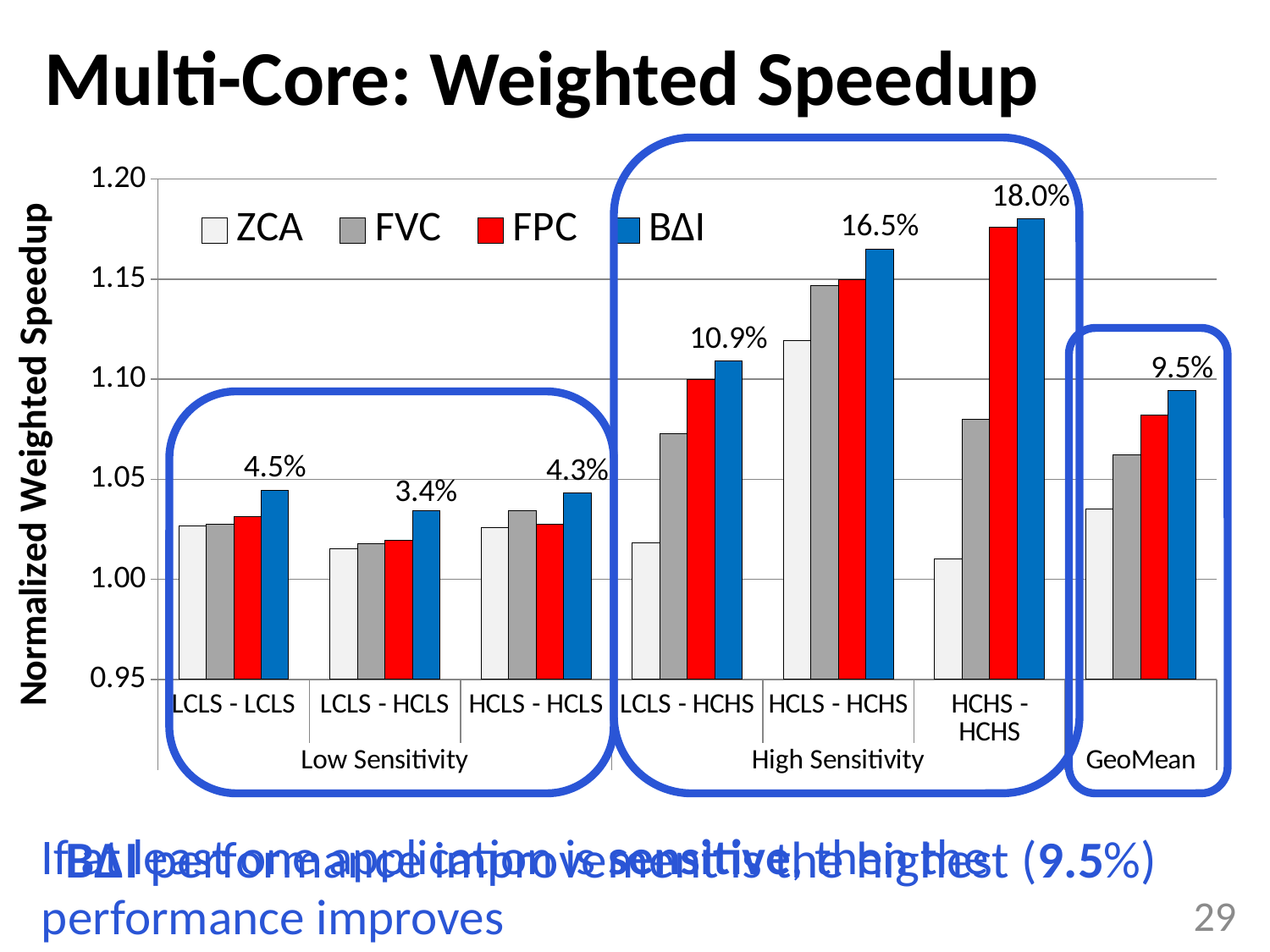
Which category has the highest percentage label printed above its BΔI bar? HCHS - HCHS How many workload categories are plotted along the x axis? 7 Is the FVC value for HCHS - HCHS greater or less than 1.10? less Which category has the lowest percentage label printed above its BΔI bar? LCLS - HCLS What percentage label is printed above the BΔI bar for LCLS - HCLS? 3.4% Is the BΔI value for HCHS - HCHS greater or less than 1.15? greater What is the title of the y axis? Normalized Weighted Speedup What kind of chart is shown on the slide? bar chart How many series does the legend list? 4 What is the difference between the percentage labels for HCHS - HCHS and GeoMean? 8.5% What percentage label is printed above the BΔI bar for GeoMean? 9.5% What percentage label is printed above the BΔI bar for HCHS - HCHS? 18.0%